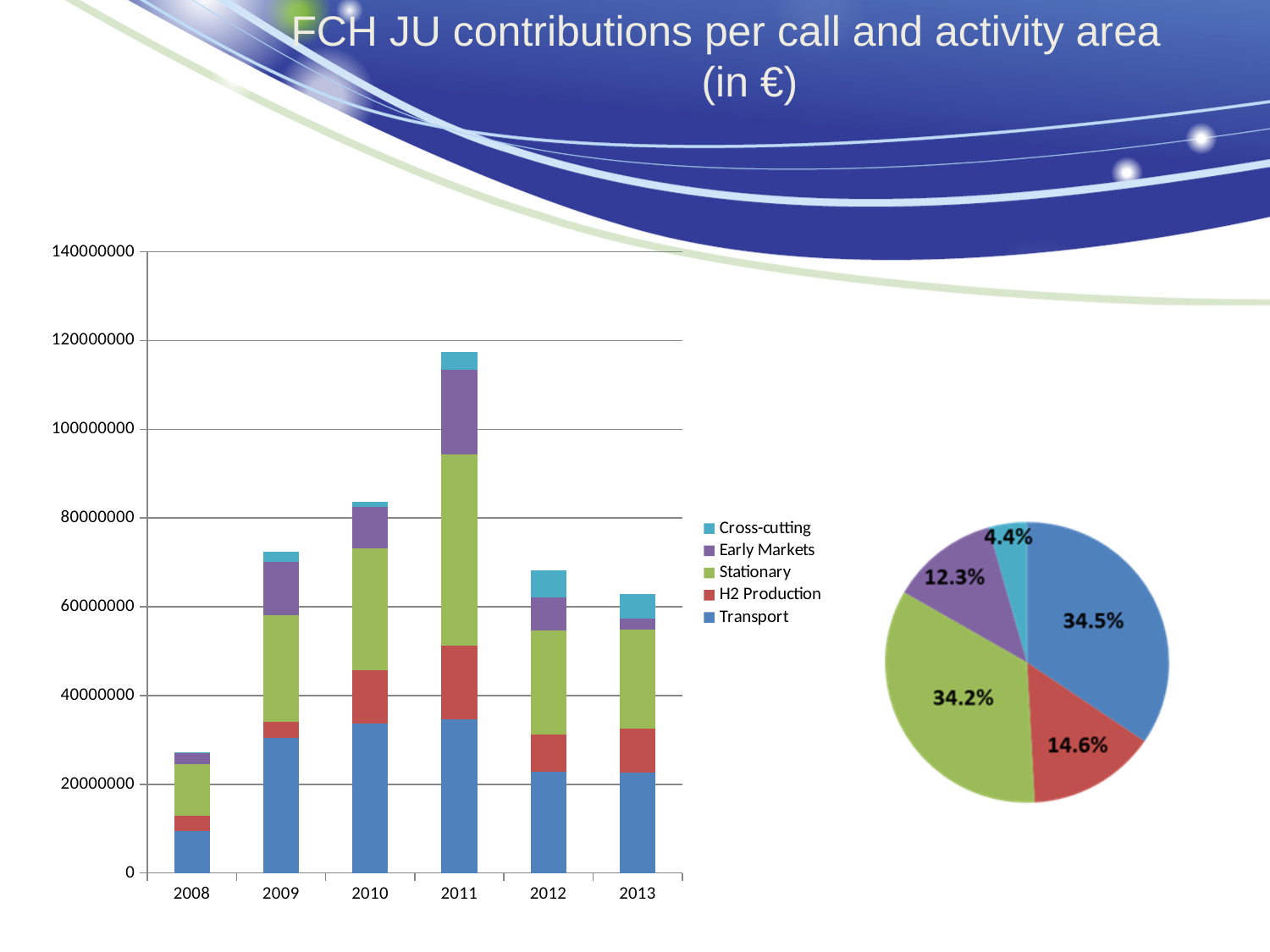
What kind of chart is the one on the right of the slide? Pie chart On the bar chart, which year has the highest total contribution? 2011 On the bar chart, which year has the lowest total contribution? 2008 How many series does the legend list? 5 On the pie chart, which slice is the smallest? Cross-cutting (4.4%) On the bar chart, is the total for 2009 greater or less than 60000000? greater On the bar chart, how many years are shown on the x axis? 6 What kind of chart is the one on the left of the slide? Stacked bar chart On the bar chart, is the total for 2008 greater or less than 40000000? less On the pie chart, what is the difference between the blue (Transport) slice and the red (H2 Production) slice? 19.9% On the pie chart, what share is shown for the blue (Transport) slice? 34.5% On the bar chart, is the total for 2011 greater or less than 100000000? greater